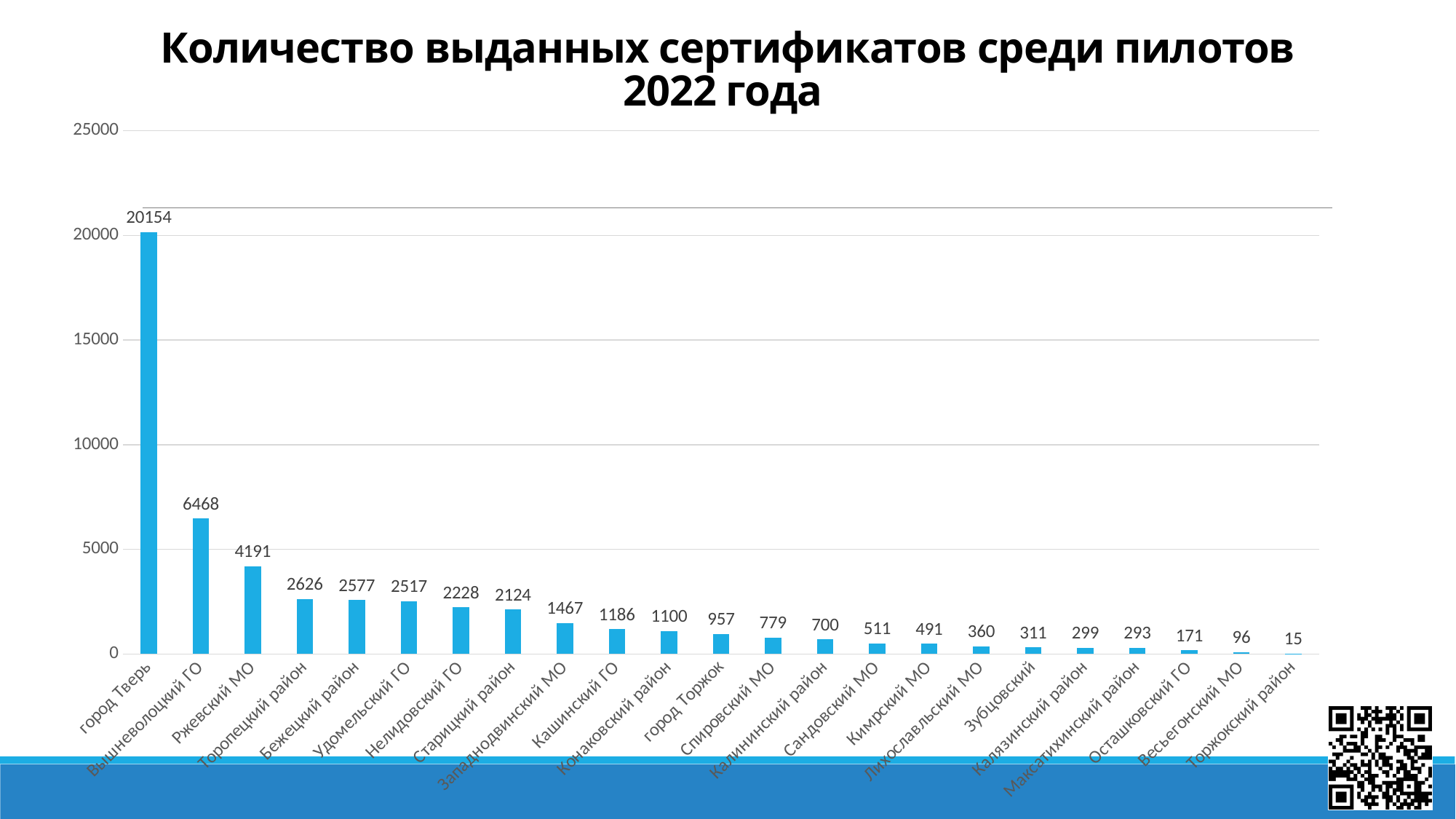
How many certificates were issued in город Тверь? 20154 What is the value shown for Конаковский район? 1100 How many categories are shown on the x axis? 23 Which is larger, the value for Кашинский ГО or the value for город Торжок? Кашинский ГО What is the value shown for Ржевский МО? 4191 What kind of chart is shown on the slide? bar chart What is the value shown for Торжокский район? 15 Which category has the highest number of certificates? город Тверь Which category has the lowest number of certificates? Торжокский район What is the difference between the values for Торопецкий район and Бежецкий район? 49 Do the values rise or fall moving from left to right along the x axis? fall What is the difference between the values for город Тверь and Вышневолоцкий ГО? 13686